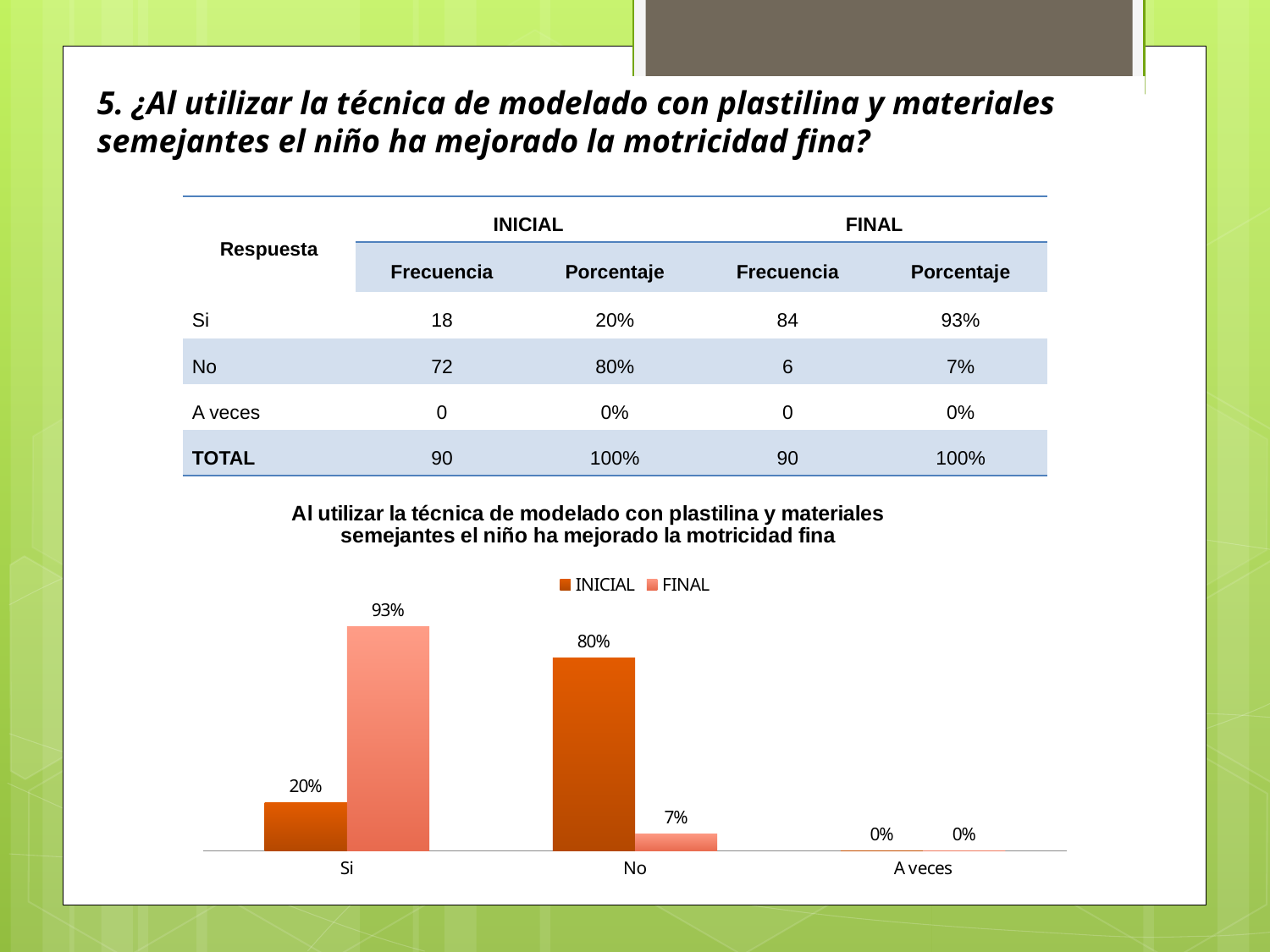
What is the INICIAL value for No? 80% What is the FINAL value for No? 7% How many categories are shown on the x axis? 3 What is the FINAL value for Si? 93% Which category has the highest FINAL value? Si What are the two series named in the legend? INICIAL and FINAL What is the difference between the FINAL and INICIAL values for Si? 73% What kind of chart is shown? Bar chart What is the INICIAL value for Si? 20% Which category has the highest INICIAL value? No Which is larger for No: the INICIAL value or the FINAL value? INICIAL How many series does the legend list? 2